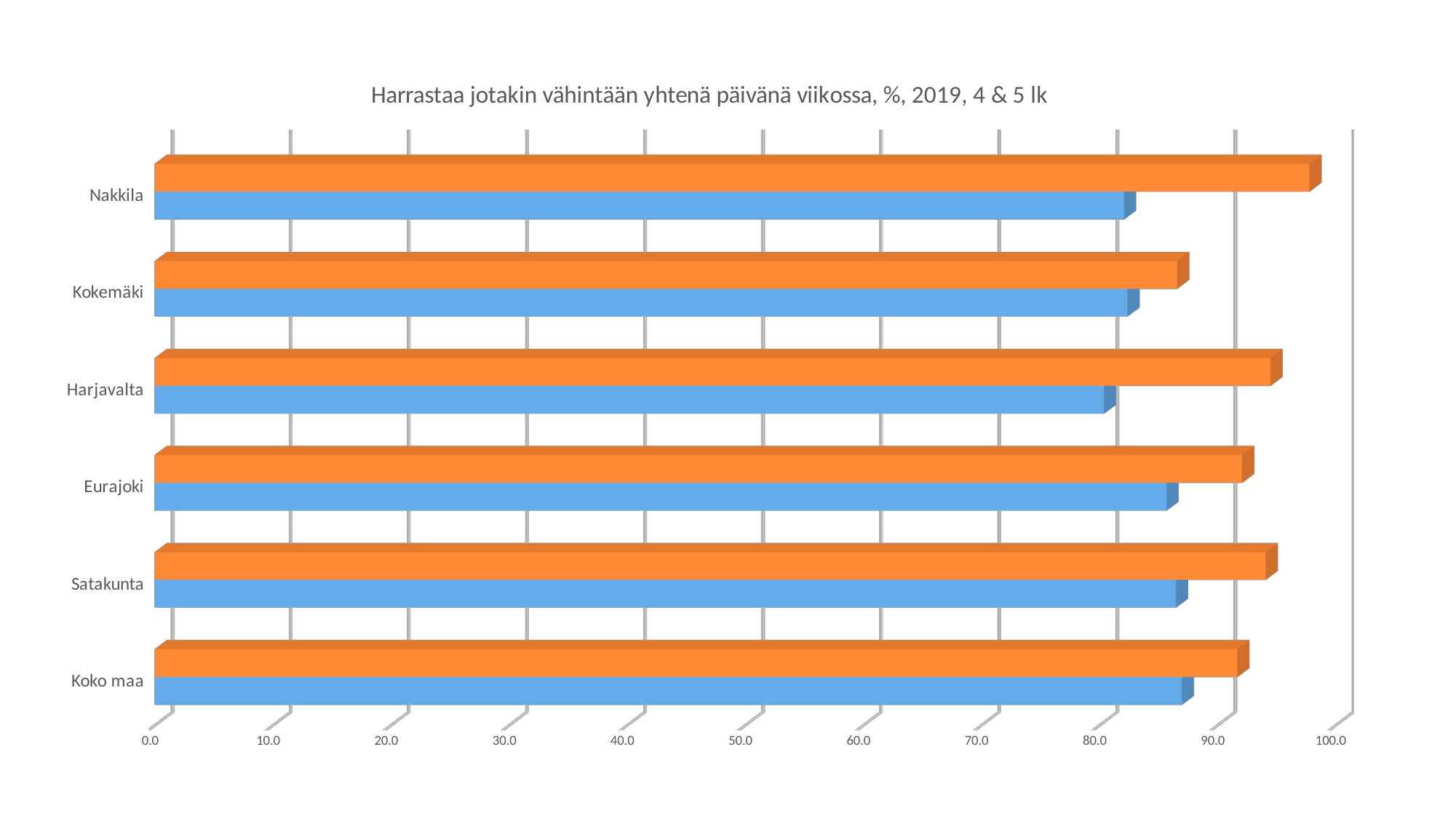
Which orange bar is longer, Nakkila or Kokemäki? Nakkila How many categories are shown on the vertical axis of the chart? 6 Is the blue bar for Harjavalta greater or less than 90.0? less Is the orange bar for Nakkila greater or less than 90.0? greater What is the title of the chart? Harrastaa jotakin vähintään yhtenä päivänä viikossa, %, 2019, 4 & 5 lk Which category has the shortest orange bar? Kokemäki Which category has the longest orange bar? Nakkila What kind of chart is shown on the slide? bar chart For Nakkila, which bar is longer, the orange one or the blue one? orange Is the orange bar for Kokemäki greater or less than 90.0? less